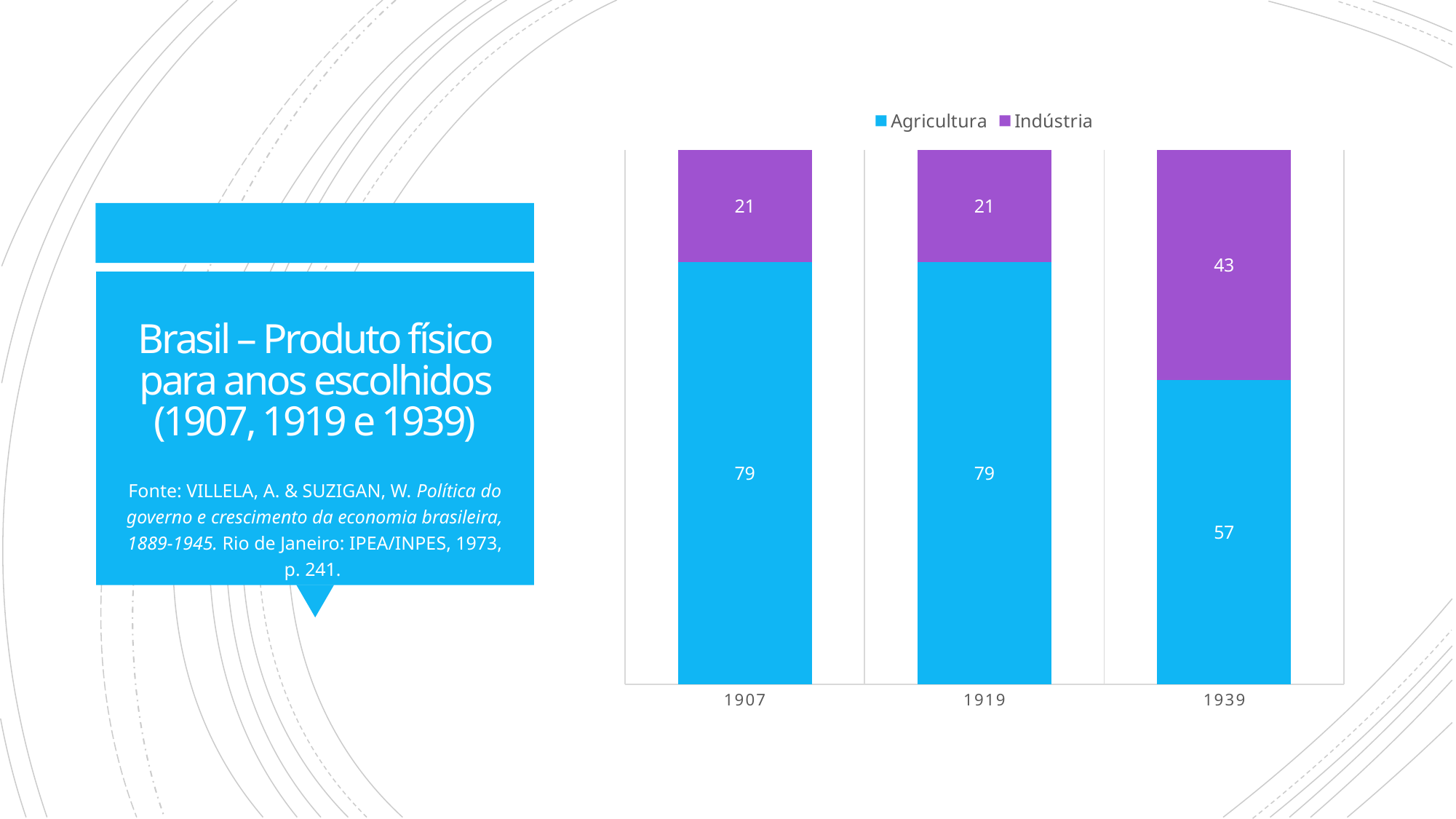
Which is larger in 1939, the Agricultura value or the Indústria value? Agricultura How many years are shown on the x axis? 3 What is the Agricultura value for 1939? 57 What is the total of the stacked bar for 1939? 100 Which year has the highest Indústria value? 1939 What is the Indústria value for 1919? 21 What is the difference between the Agricultura value for 1907 and the Agricultura value for 1939? 22 How many series does the legend list? 2 What is the Indústria value for 1939? 43 What kind of chart is shown on the slide? Stacked bar chart Which year has the lowest Agricultura value? 1939 What is the Agricultura value for 1907? 79